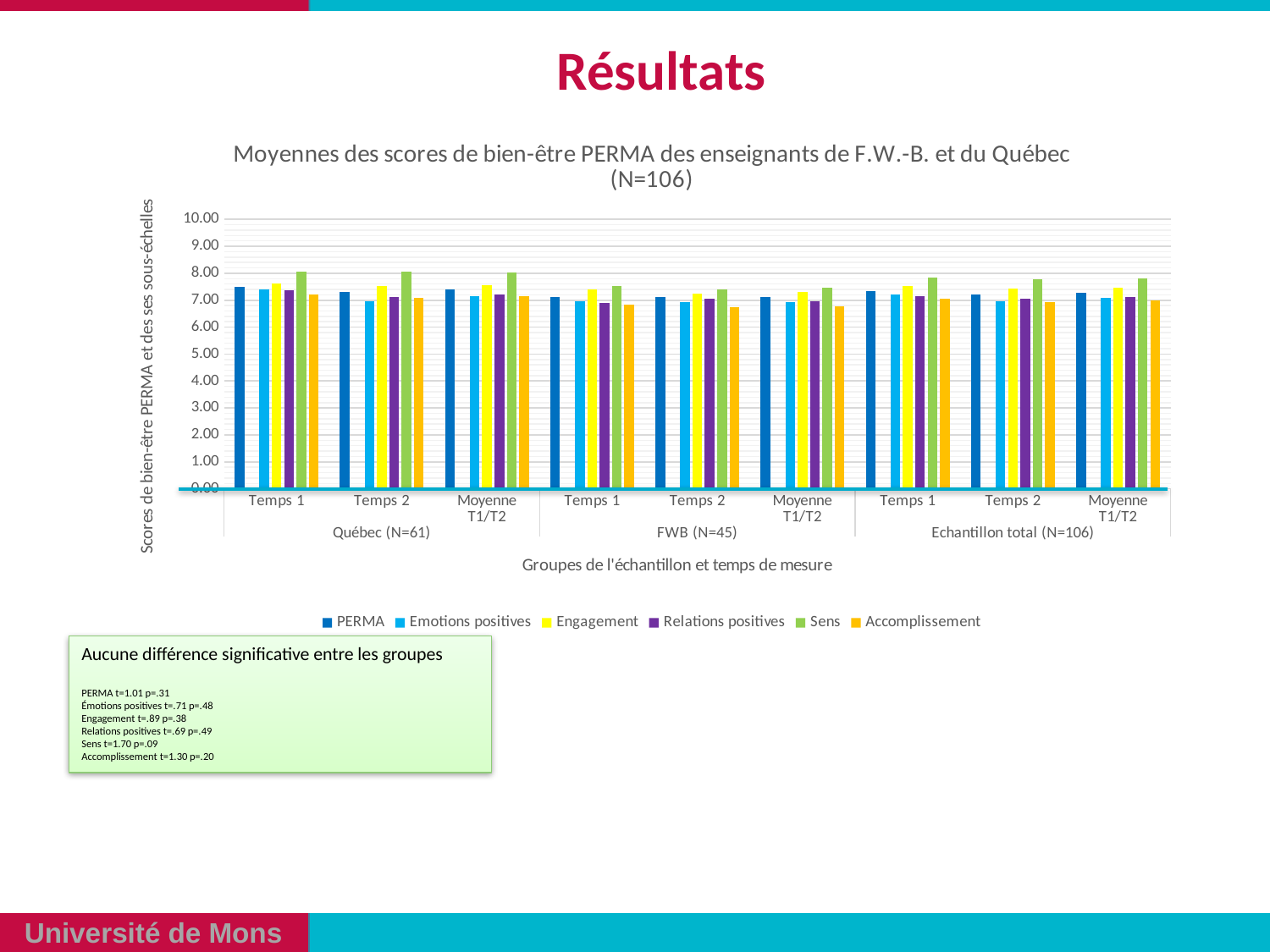
What kind of chart is shown on the slide? bar chart Is the value for PERMA at Moyenne T1/T2 in the Echantillon total (N=106) group greater or less than 6.00? greater Which series has the highest bar for Temps 1 in the Québec (N=61) group? Sens Is the value for Sens at Temps 1 in the Québec (N=61) group greater or less than 7.00? greater Which series has the highest bar for Temps 1 in the Echantillon total (N=106) group? Sens How many category groups (time points) are shown along the x axis of the chart? 9 What is the title of the chart? Moyennes des scores de bien-être PERMA des enseignants de F.W.-B. et du Québec (N=106) How many series does the chart legend list? 6 What is the label of the x axis of the chart? Groupes de l'échantillon et temps de mesure For Temps 1 in the FWB (N=45) group, which is larger: Sens or Relations positives? Sens Is the value for Accomplissement at Temps 2 in the FWB (N=45) group greater or less than 8.00? less For Temps 2 in the Québec (N=61) group, which is larger: Sens or Accomplissement? Sens